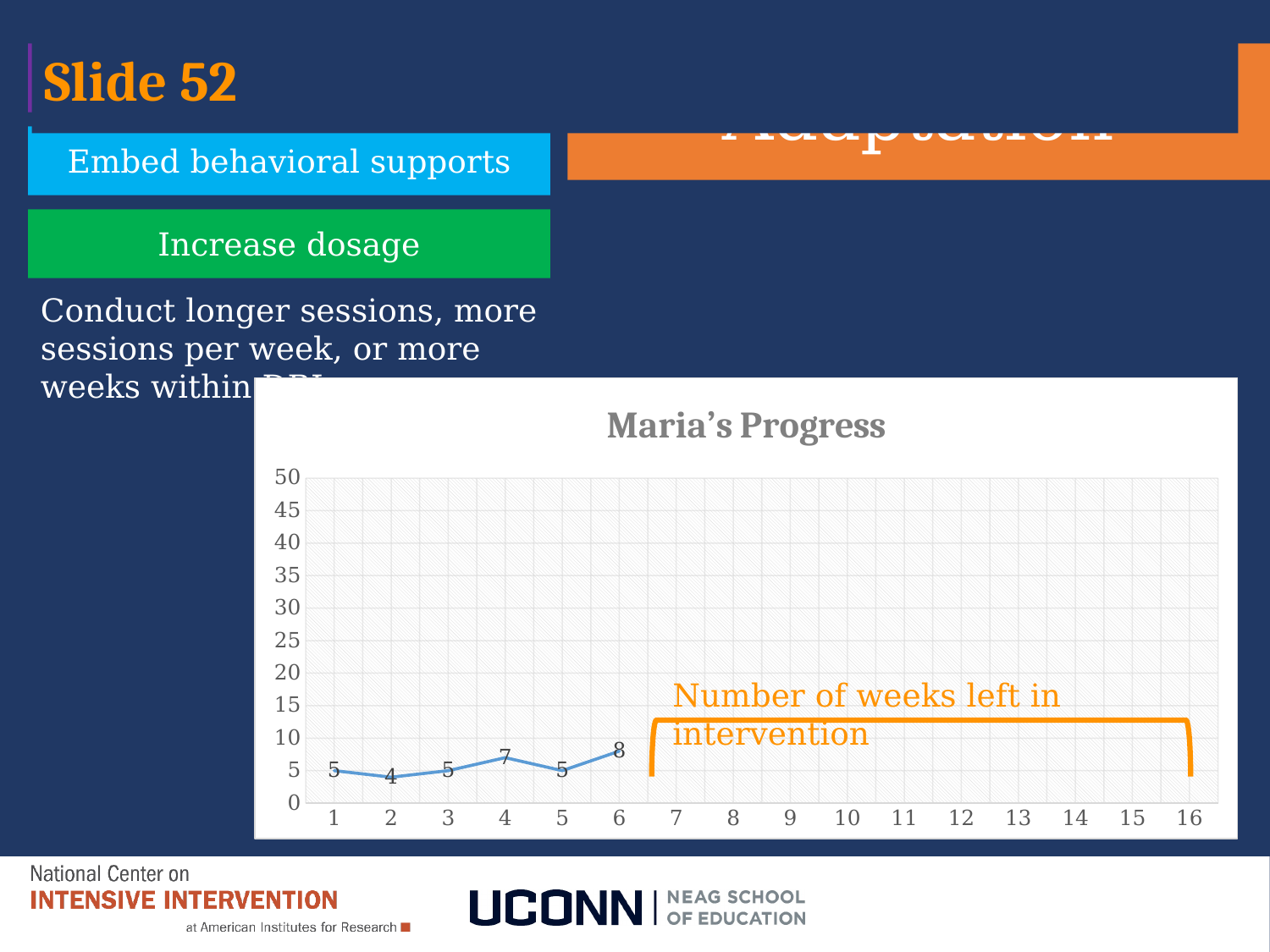
In "Maria's Progress", what is the value at week 1? 5 In "Maria's Progress", what is the value at week 2? 4 In "Maria's Progress", what is the value at week 4? 7 In "Maria's Progress", what is the value at week 6? 8 In "Maria's Progress", which week has the lowest plotted value? 2 What is the title of the chart on the slide? Maria's Progress In "Maria's Progress", which week has the highest plotted value? 6 In "Maria's Progress", is the value at week 4 larger or smaller than the value at week 5? larger In "Maria's Progress", what is the difference between the values at week 6 and week 2? 4 In "Maria's Progress", is the value at week 6 greater or less than 10? less What kind of chart is "Maria's Progress"? line chart In "Maria's Progress", how many data points are plotted? 6